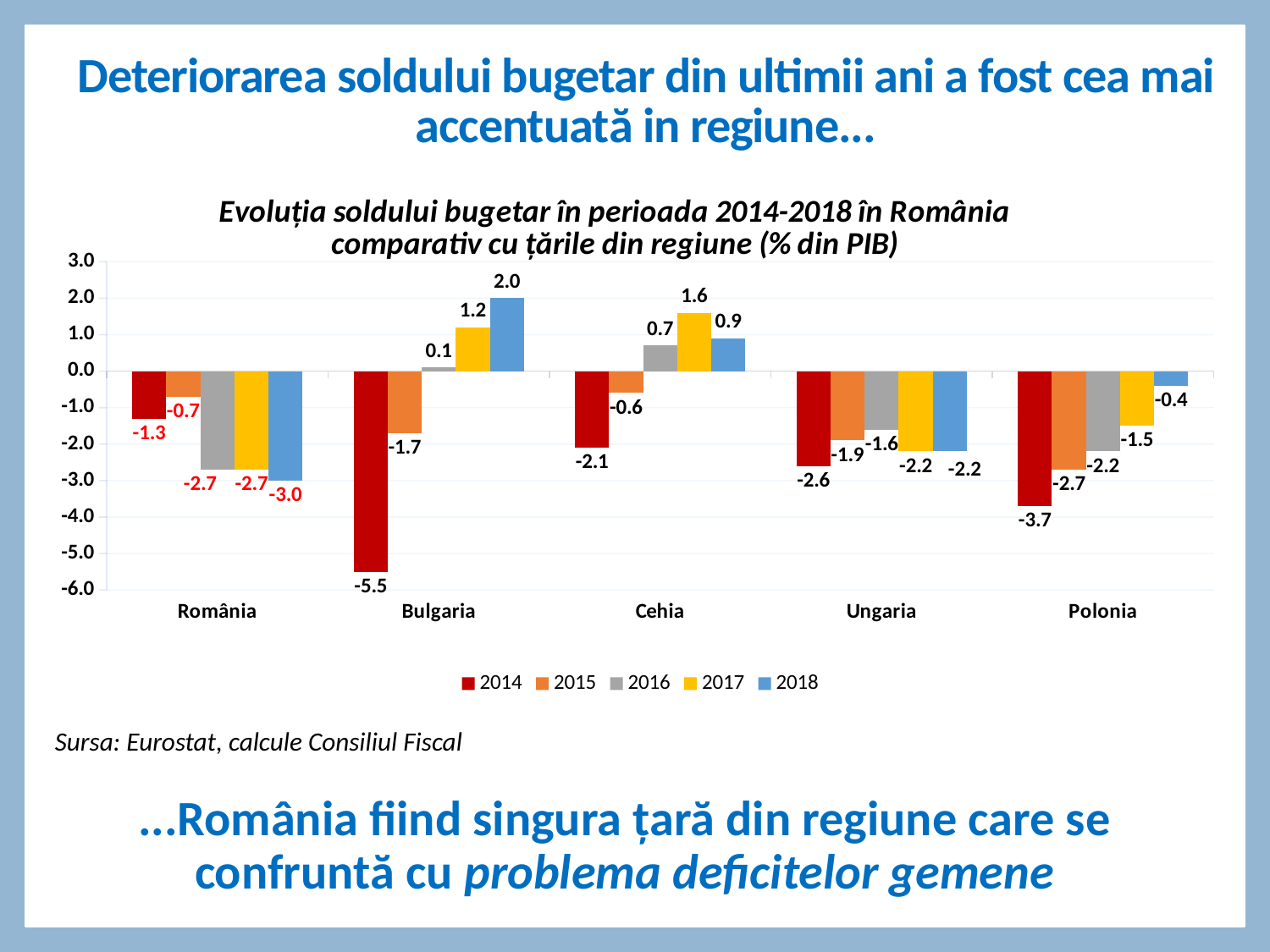
Which country has the highest value in 2018? Bulgaria What is the difference between the 2018 values for Bulgaria and România? 5.0 Which country has the lowest value in 2014? Bulgaria What is the value for Bulgaria in 2014? -5.5 What is the value for Cehia in 2017? 1.6 How many series does the legend list? 5 Do the values for Polonia rise or fall from 2014 to 2018? Rise What is the value for Polonia in 2018? -0.4 What kind of chart is shown on the slide? Bar chart What is the value for România in 2018? -3.0 How many countries are shown on the x axis? 5 Which is larger, the 2017 value for Cehia or the 2017 value for Bulgaria? Cehia